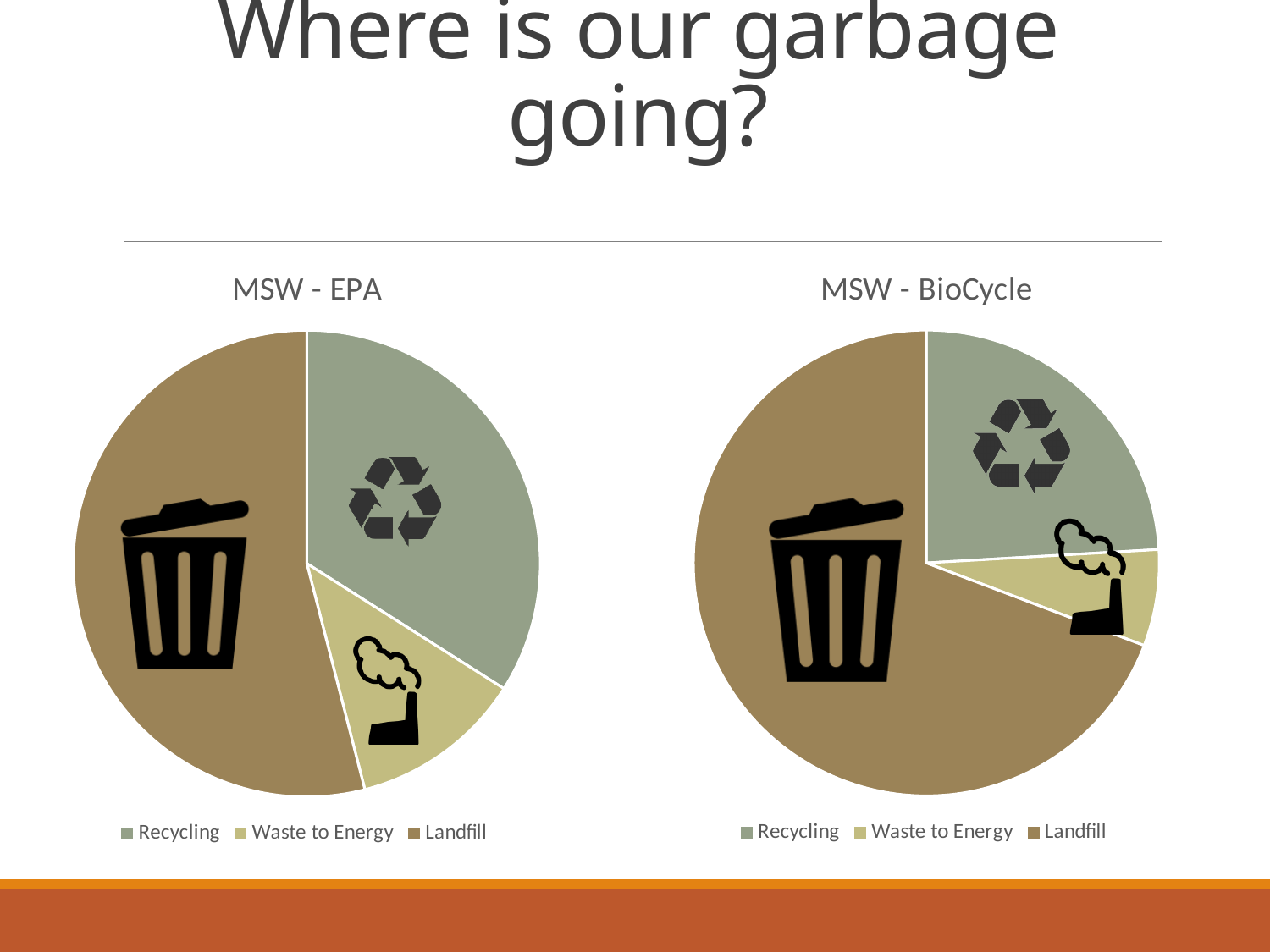
In the "MSW - EPA" chart, which category has the largest slice? Landfill How many entries does the legend of the "MSW - BioCycle" chart list? 3 In the "MSW - BioCycle" chart, which category has the largest slice? Landfill In the "MSW - BioCycle" chart, which category has the smallest slice? Waste to Energy In the "MSW - EPA" chart, which slice is larger: Recycling or Waste to Energy? Recycling What kind of chart is the "MSW - EPA" chart? pie chart In the "MSW - BioCycle" chart, which category is shown in the darkest brown colour? Landfill What is the title of the pie chart on the left of the slide? MSW - EPA Is the Landfill slice larger in the "MSW - EPA" chart or in the "MSW - BioCycle" chart? MSW - BioCycle In the "MSW - EPA" chart, which category has the smallest slice? Waste to Energy What kind of chart is the "MSW - BioCycle" chart? pie chart How many slices does the "MSW - EPA" pie chart have? 3